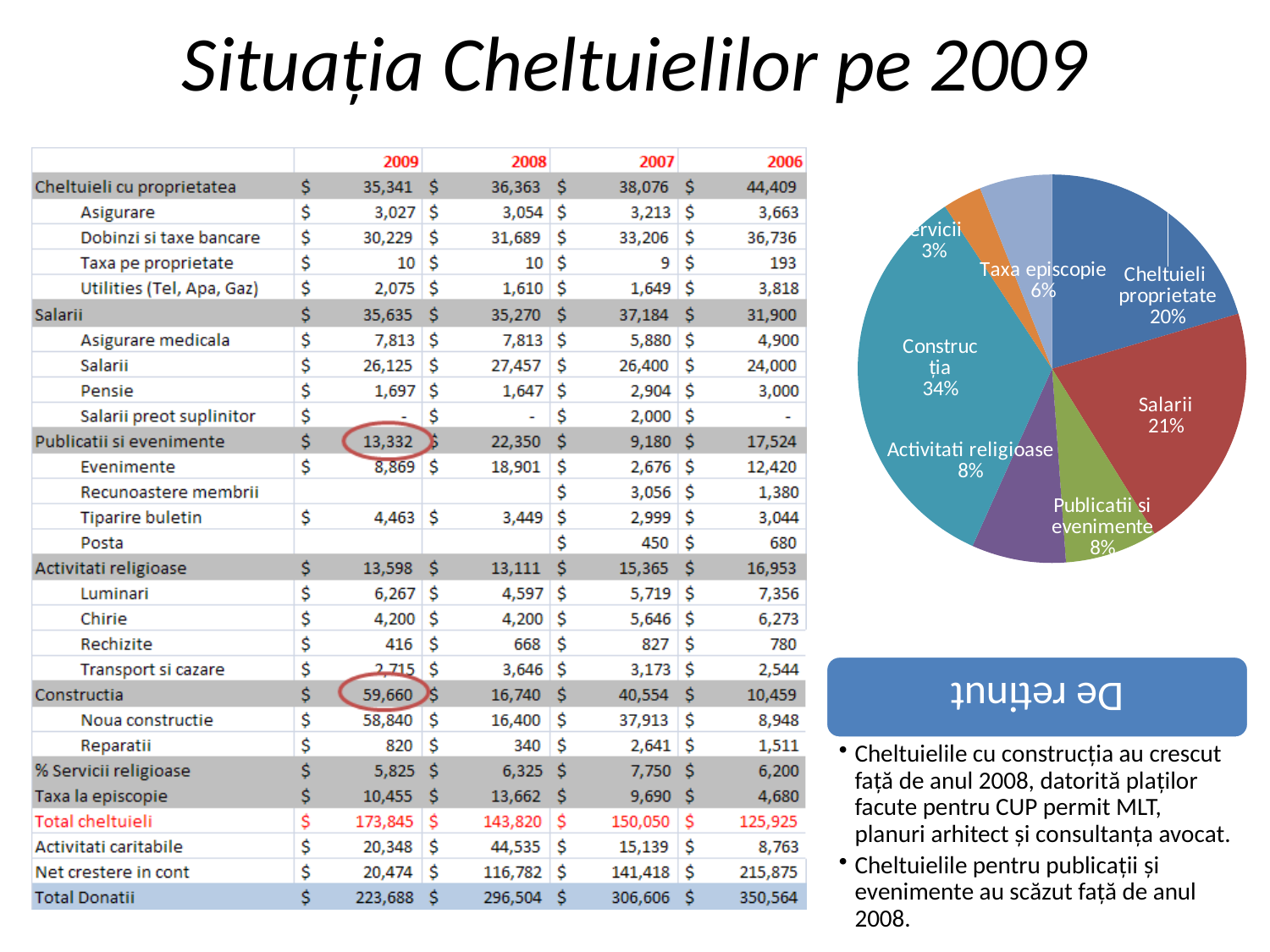
In the pie chart, what share does Salarii have? 21% In the pie chart, what share does Construcția have? 34% In the pie chart, what share does Activitati religioase have? 8% In the pie chart, what is the combined share of Publicații și evenimente and Activitati religioase? 16% In the pie chart, which is larger: Salarii or Cheltuieli proprietate? Salarii How many slices does the pie chart have? 7 In the pie chart, what is the difference in percentage points between Construcția and Salarii? 13 Which slice of the pie chart is the largest? Construcția What kind of chart is shown on the slide? pie chart